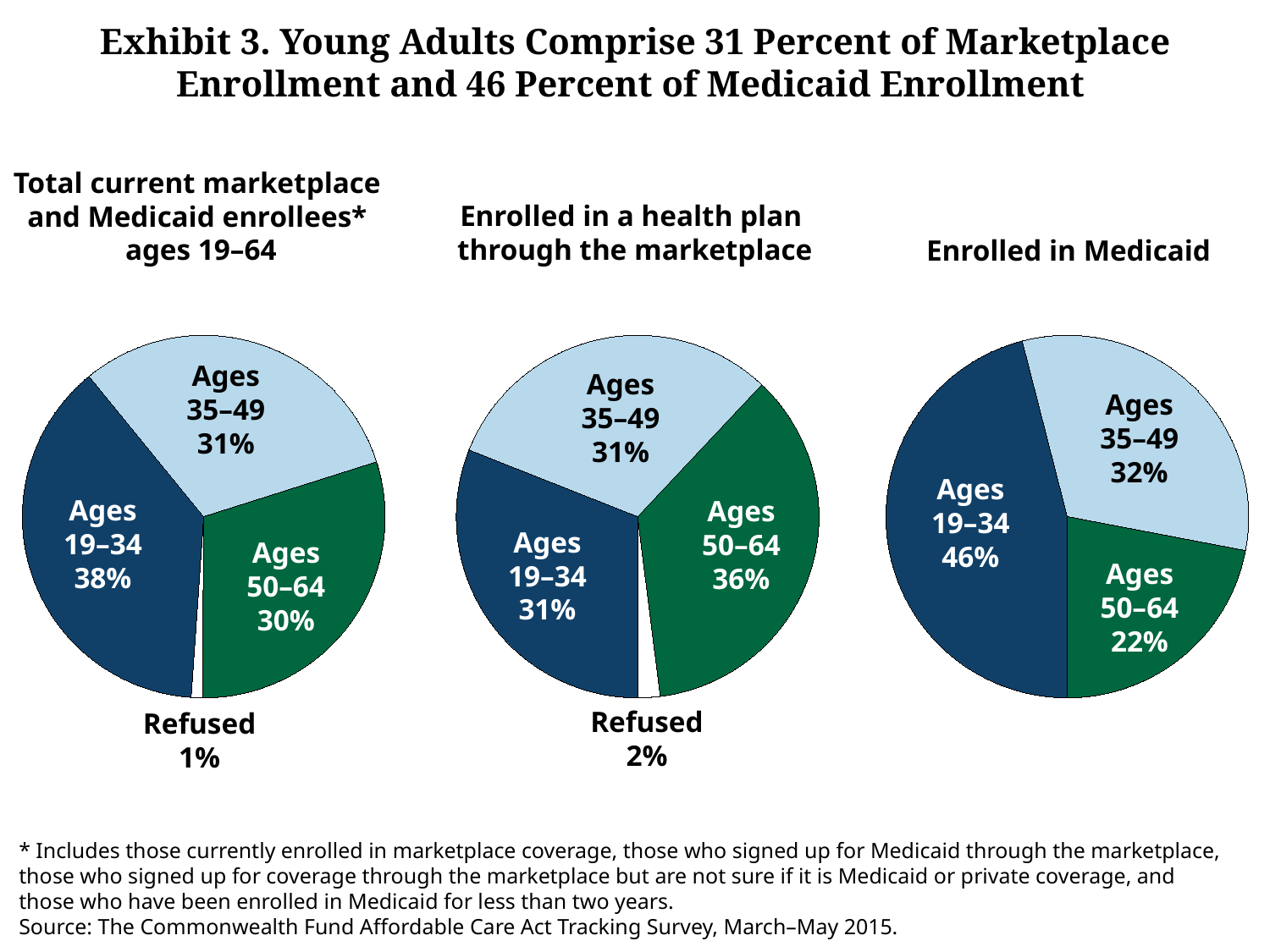
In the 'Enrolled in Medicaid' pie chart, what share of enrollees are ages 19–34? 46% In the 'Enrolled in Medicaid' pie chart, which age group has the largest share? Ages 19–34 How many slices does the 'Enrolled in Medicaid' pie chart have? 3 In the 'Enrolled in a health plan through the marketplace' pie chart, which category has the smallest share? Refused How many slices does the 'Total current marketplace and Medicaid enrollees ages 19–64' pie chart have? 4 How many pie charts are shown on the slide? 3 What type of chart is used on this slide? Pie chart In the 'Total current marketplace and Medicaid enrollees ages 19–64' pie chart, which age group has the largest share? Ages 19–34 In the 'Enrolled in Medicaid' pie chart, what is the difference in percentage points between the ages 19–34 share and the ages 50–64 share? 24 In the 'Enrolled in a health plan through the marketplace' pie chart, what share of enrollees are ages 50–64? 36% In the 'Enrolled in a health plan through the marketplace' pie chart, which is larger: the share for ages 35–49 or the share for ages 50–64? Ages 50–64 In the 'Total current marketplace and Medicaid enrollees ages 19–64' pie chart, what share refused? 1%